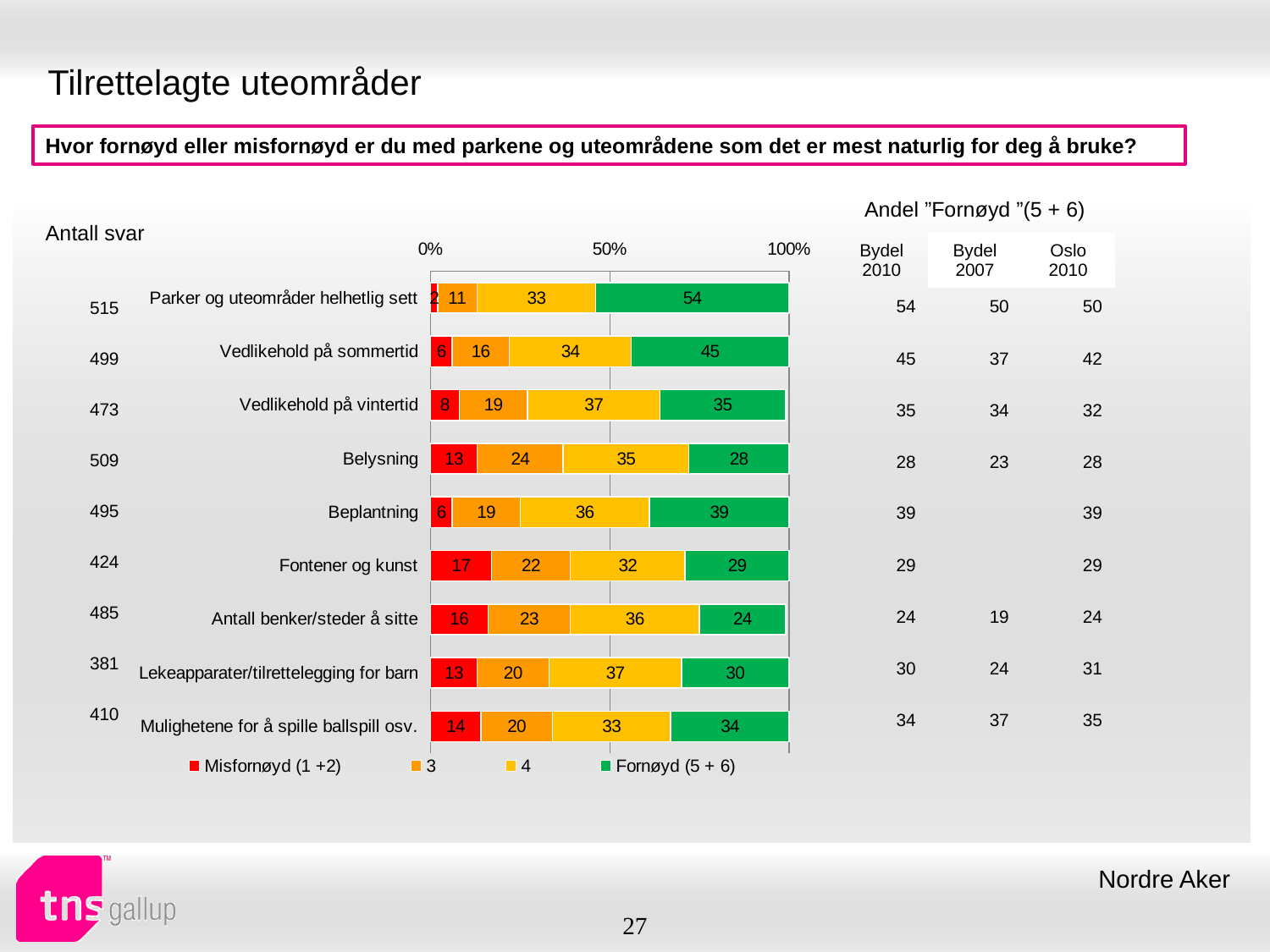
Which category has the highest value for the "Fornøyd (5 + 6)" series? Parker og uteområder helhetlig sett What is the value of the "Misfornøyd (1 +2)" series for "Fontener og kunst"? 17 What is the value of series "3" for "Belysning"? 24 What is the value of the "Fornøyd (5 + 6)" series for "Parker og uteområder helhetlig sett"? 54 How many series does the legend list? 4 What kind of chart is shown on the slide? Stacked bar chart What is the total of the stacked bar for "Mulighetene for å spille ballspill osv."? 101 Which has a larger "Misfornøyd (1 +2)" value: "Belysning" or "Beplantning"? Belysning What is the difference between the "Fornøyd (5 + 6)" values for "Vedlikehold på sommertid" and "Vedlikehold på vintertid"? 10 What is the value of series "4" for "Vedlikehold på vintertid"? 37 Which category has the lowest value for the "Fornøyd (5 + 6)" series? Antall benker/steder å sitte How many categories are shown in the chart? 9